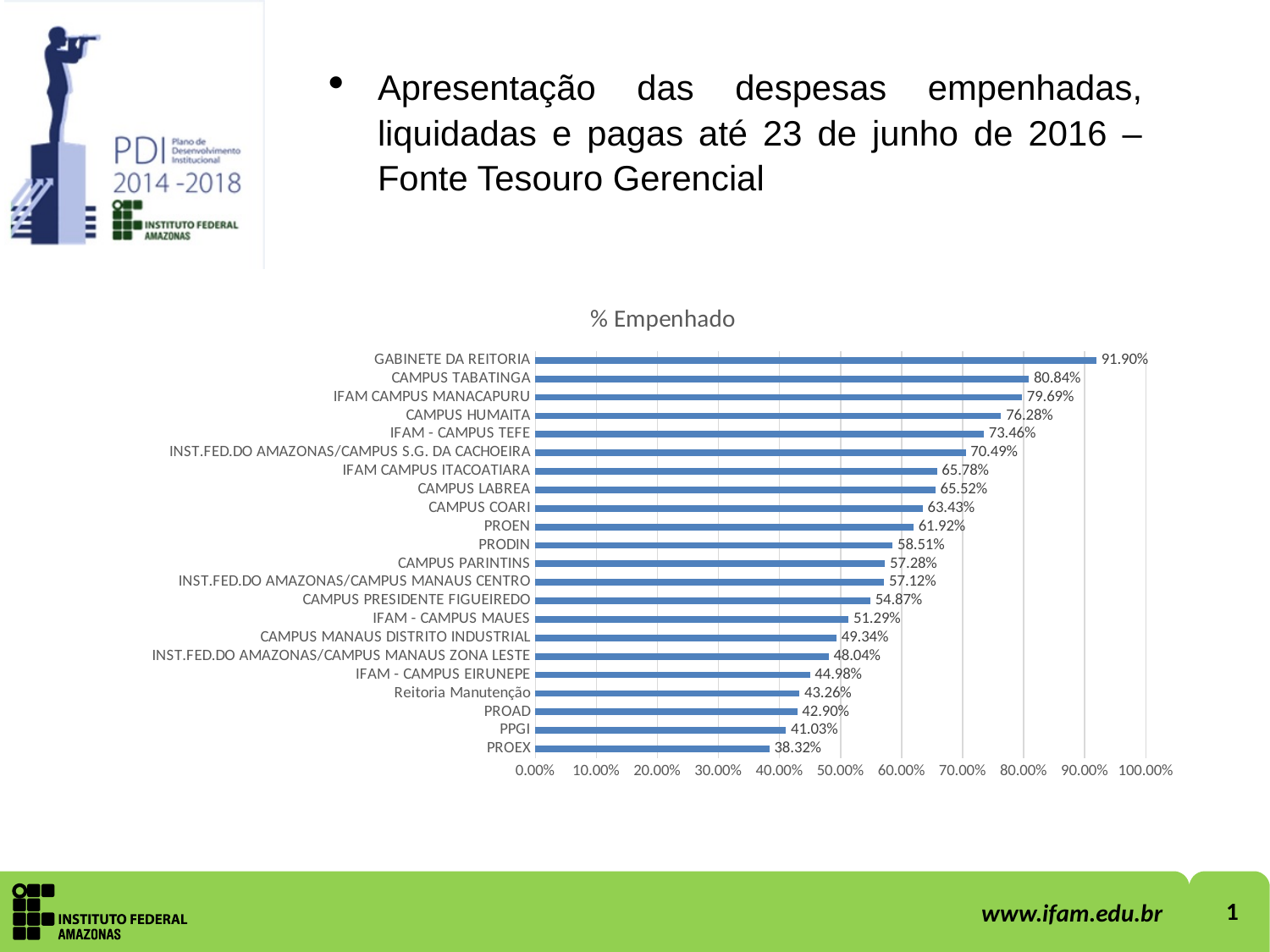
Is the % Empenhado value for PROAD greater or less than 50.00%? less What type of chart is used to show % Empenhado? Bar chart What is the % Empenhado value for PPGI? 41.03% What is the % Empenhado value for GABINETE DA REITORIA? 91.90% How many categories are shown in the % Empenhado chart? 22 Which has a higher % Empenhado, CAMPUS HUMAITA or PROEN? CAMPUS HUMAITA Which category has the highest % Empenhado? GABINETE DA REITORIA What is the difference in % Empenhado between CAMPUS TABATINGA and IFAM CAMPUS MANACAPURU? 1.15% Which category has the lowest % Empenhado? PROEX What is the title of the chart on the slide? % Empenhado What is the % Empenhado value for CAMPUS COARI? 63.43% What is the difference in % Empenhado between GABINETE DA REITORIA and PROEX? 53.58%